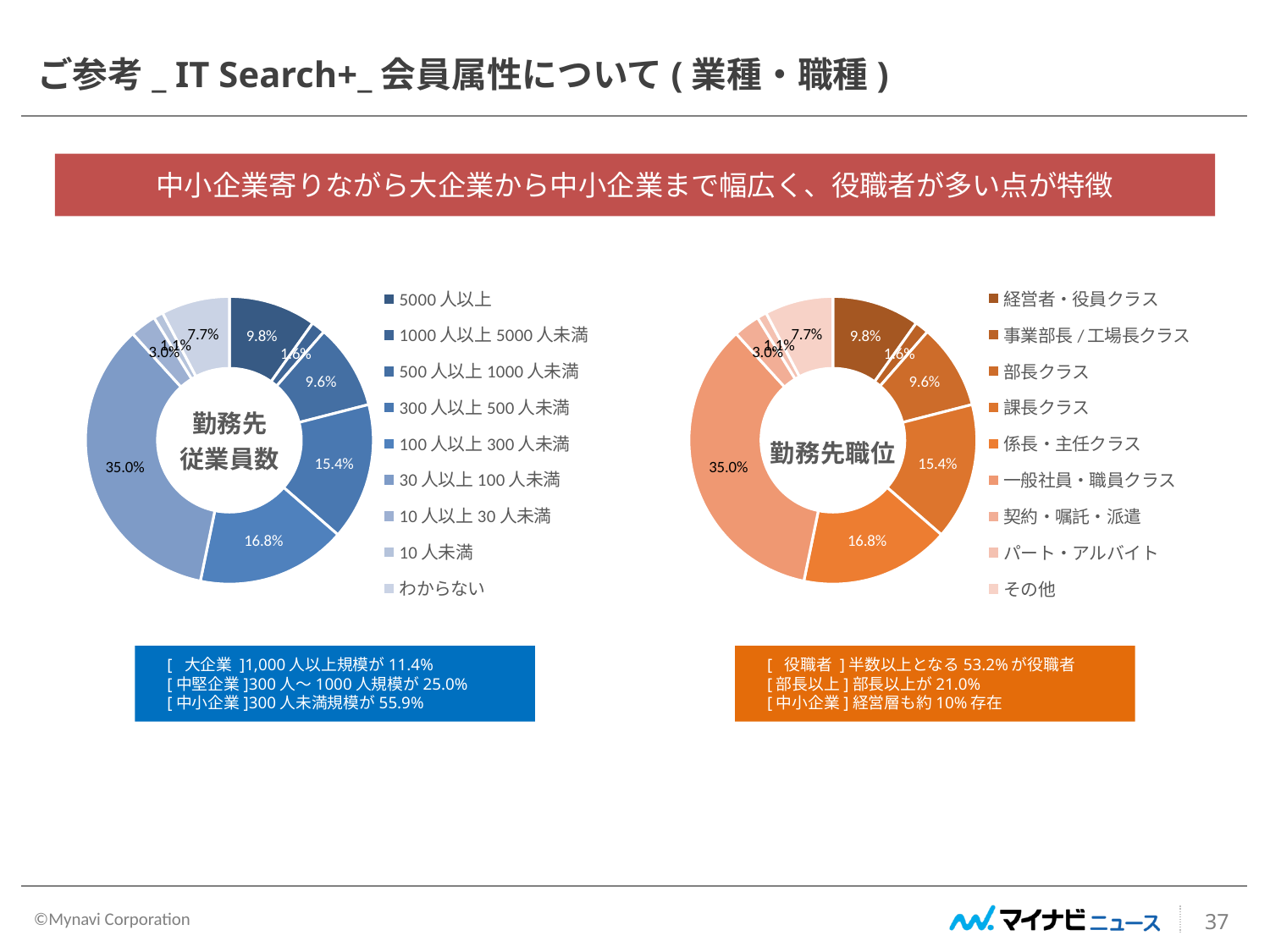
How many categories does the legend of the 勤務先従業員数 chart list? 9 In the 勤務先従業員数 chart, which category has the largest share? 30人以上100人未満 In the 勤務先従業員数 chart, what percentage is shown for 5000人以上? 9.8% In the 勤務先従業員数 chart, what percentage is shown for 30人以上100人未満? 35.0% In the 勤務先職位 chart, what percentage is shown for その他? 7.7% In the 勤務先職位 chart, what percentage is shown for 一般社員・職員クラス? 35.0% What kind of chart is the 勤務先従業員数 chart on the left? Pie (donut) chart What is the title shown in the centre of the right-hand donut chart? 勤務先職位 In the 勤務先職位 chart, what percentage is shown for 課長クラス? 15.4% In the 勤務先職位 chart, what is the combined share of 経営者・役員クラス and 事業部長/工場長クラス? 11.4% In the 勤務先職位 chart, which is larger: 経営者・役員クラス or 部長クラス? 経営者・役員クラス In the 勤務先従業員数 chart, what is the difference between the 100人以上300人未満 share and the 300人以上500人未満 share? 1.4%